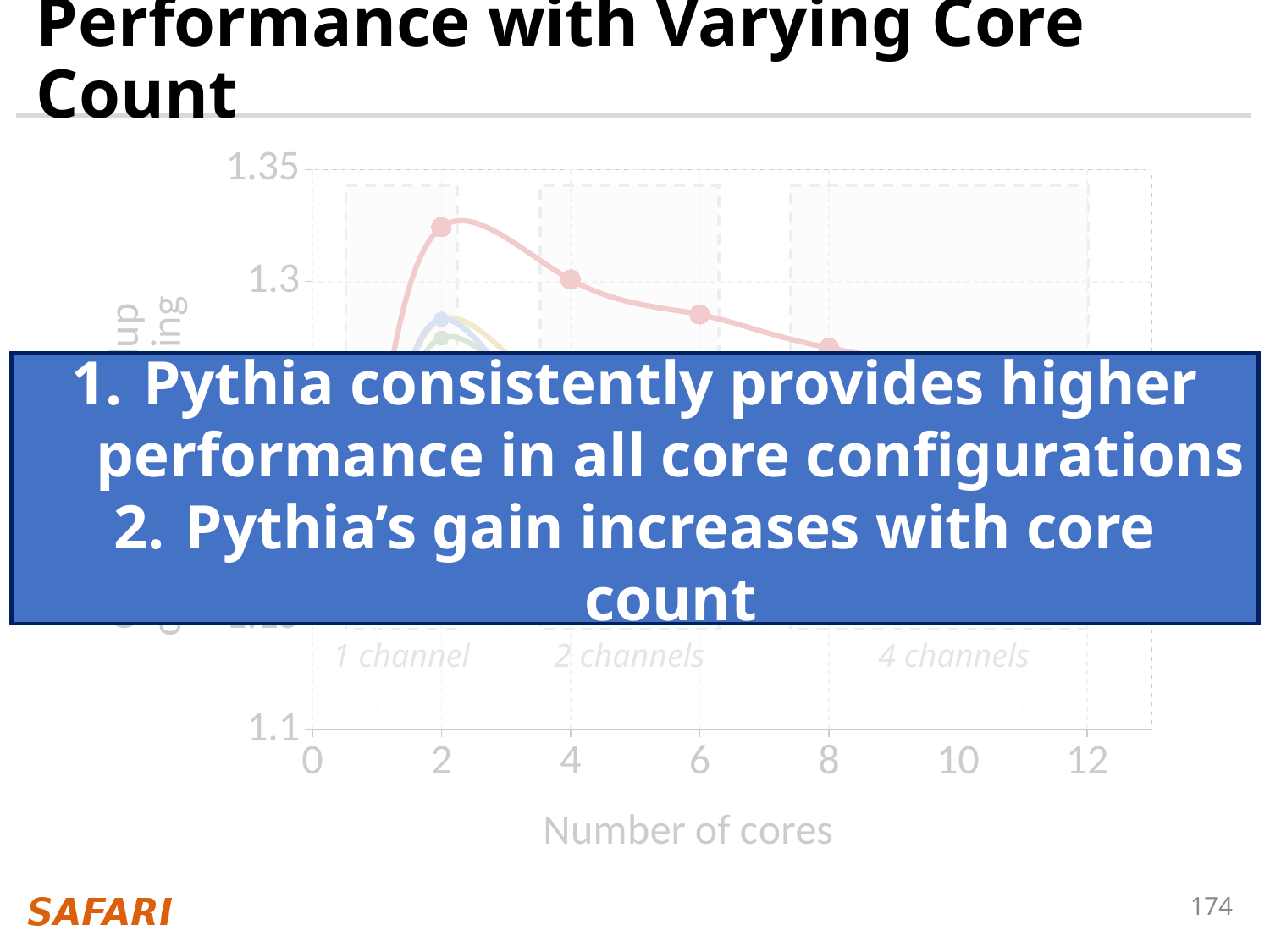
Does the red (topmost) line rise or fall as the number of cores increases from 2 to 8? fall What is the highest tick value shown on the y axis of the chart? 1.35 Which is larger for the red (topmost) line: the value at 2 cores or the value at 6 cores? 2 cores What kind of chart is shown on the slide? line chart Is the value of the red (topmost) line at 6 cores greater or less than 1.3? less What is the title of the x axis of the chart? Number of cores How many tick labels are shown on the x axis of the chart? 7 Is the value of the red (topmost) line at 2 cores greater or less than 1.3? greater What value does the red (topmost) line reach at 4 cores? 1.3 At which number of cores does the red (topmost) line reach its highest value? 2